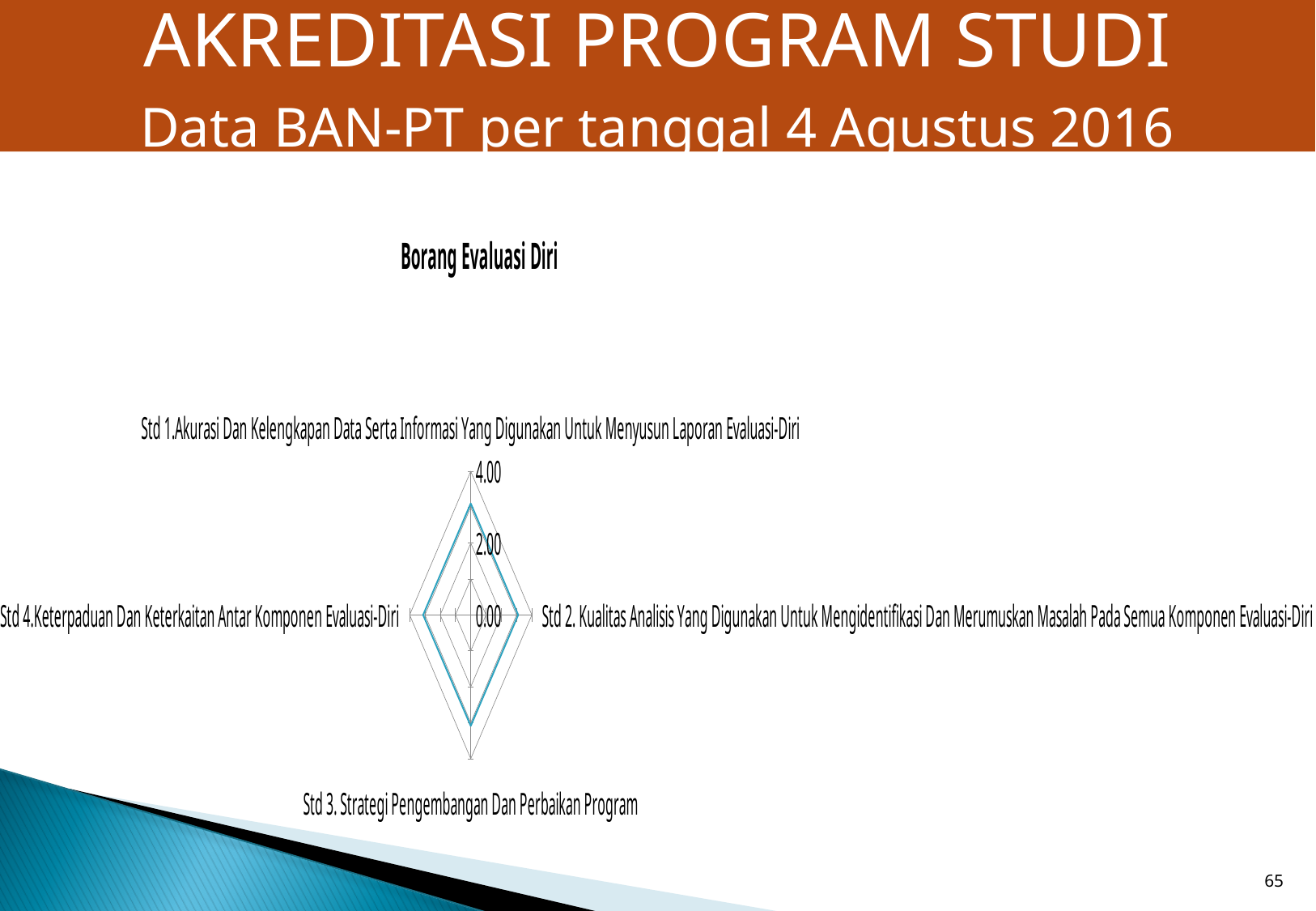
What is the highest tick value shown on the radar chart's axis? 4.00 Is the value for Std 2 (Kualitas Analisis Yang Digunakan Untuk Mengidentifikasi Dan Merumuskan Masalah Pada Semua Komponen Evaluasi-Diri) greater or less than 2.00? greater Which category label appears at the bottom of the radar chart? Std 3. Strategi Pengembangan Dan Perbaikan Program Is the value for Std 4 (Keterpaduan Dan Keterkaitan Antar Komponen Evaluasi-Diri) greater or less than 4.00? less What is the title of the chart? Borang Evaluasi Diri Is the value for Std 1 (Akurasi Dan Kelengkapan Data Serta Informasi Yang Digunakan Untuk Menyusun Laporan Evaluasi-Diri) greater or less than 2.00? greater What kind of chart is shown on the slide? radar chart How many categories (axes) does the radar chart have? 4